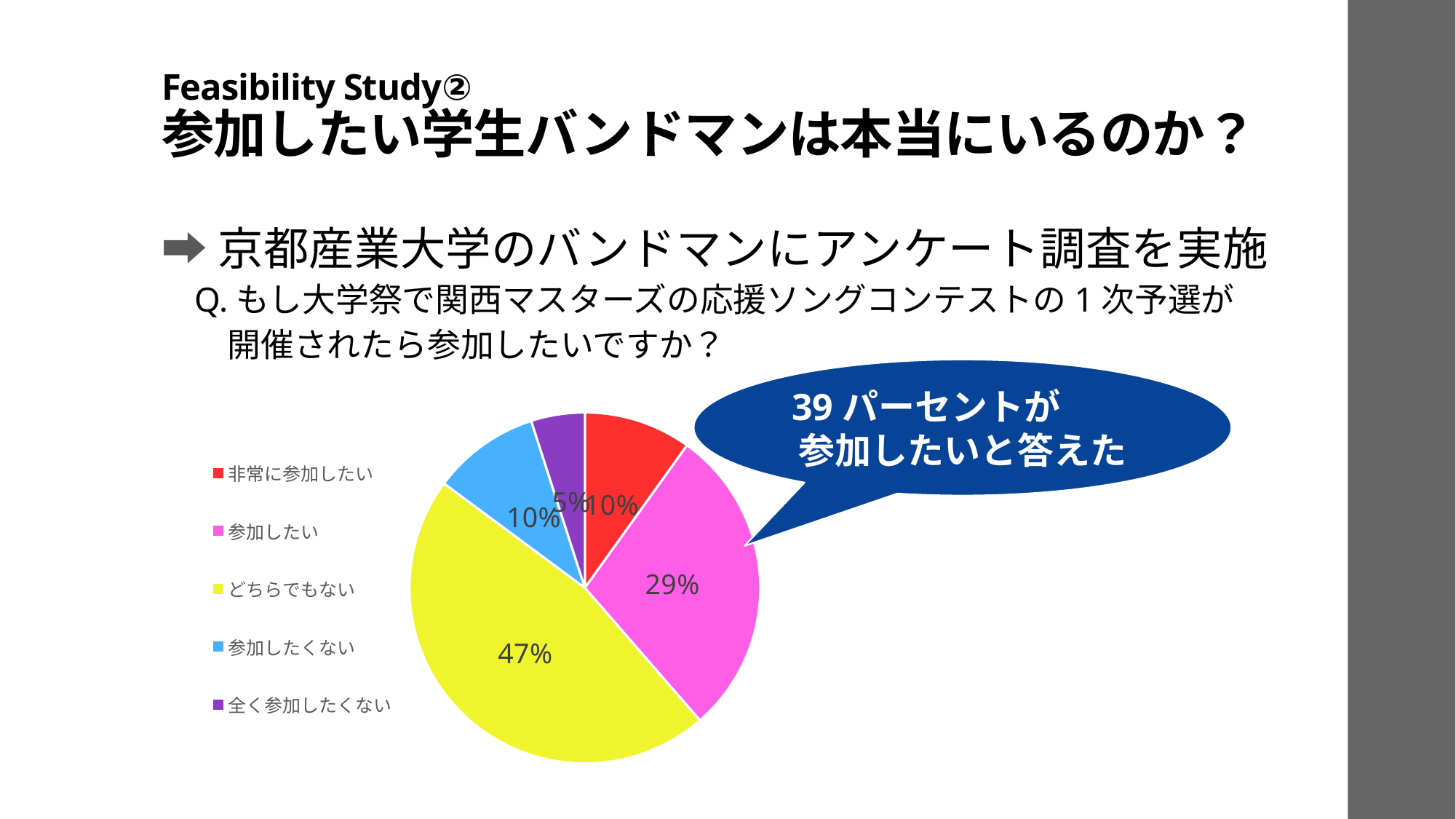
What share of the pie does 非常に参加したい take? 10% Which category has the largest slice of the pie? どちらでもない What is the combined share of 非常に参加したい and 参加したい? 39% What share of the pie does 参加したい take? 29% How many categories does the pie chart's legend list? 5 Which category has the smallest slice of the pie? 全く参加したくない What share of the pie does どちらでもない take? 47% Which is larger, the share for 参加したい or the share for 参加したくない? 参加したい What kind of chart is shown on the slide? pie chart What is the difference between the shares for どちらでもない and 参加したい? 18% What colour is the slice for どちらでもない? yellow